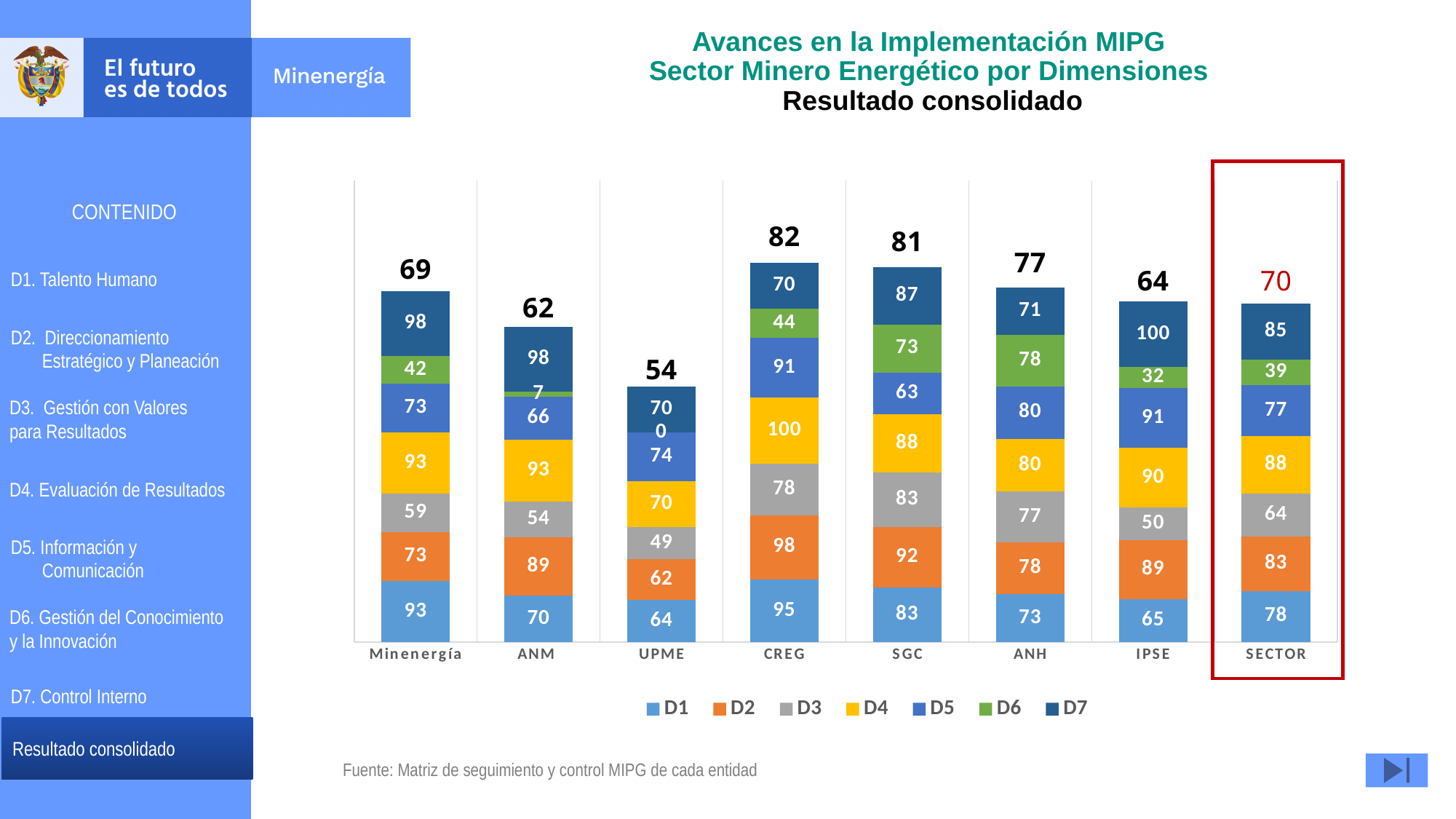
What is the D5 value for UPME? 74 What kind of chart is shown on the slide? Stacked bar chart Which entity has the highest consolidated result printed above its bar? CREG What is the D1 value for CREG? 95 What is the D6 value for ANM? 7 What consolidated result is printed above the SECTOR bar? 70 How many entities are shown on the x axis? 8 What is the D7 value for IPSE? 100 Which entity has the lowest consolidated result printed above its bar? UPME Which is larger, the D2 value for SGC or the D2 value for ANH? SGC How many series does the legend list? 7 What is the difference between the D1 value for CREG and the D1 value for IPSE? 30